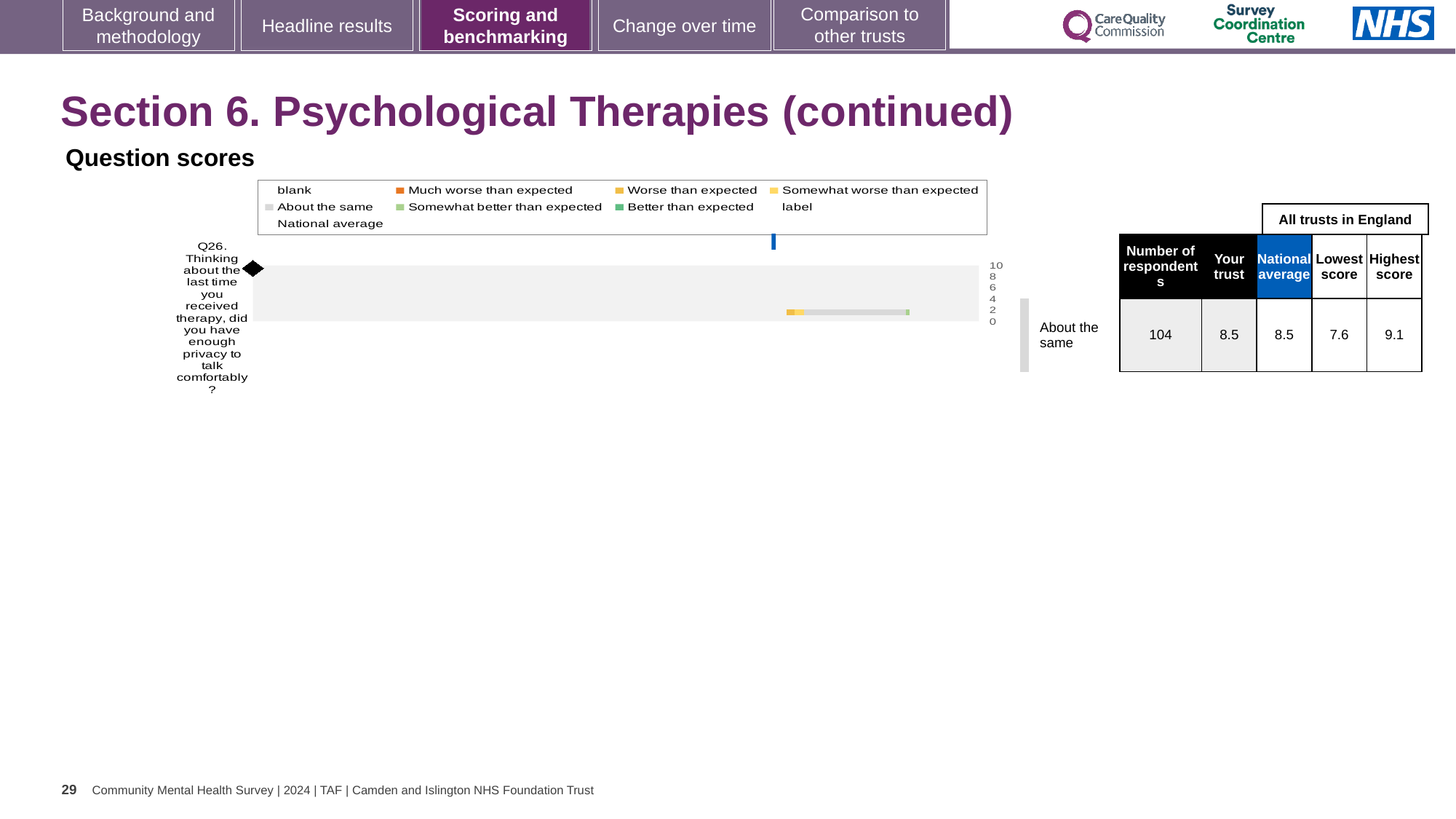
What is the highest score among all trusts in England for Q26? 9.1 What benchmark category is given for Q26 next to the chart? About the same What is the difference between the highest score and the lowest score for Q26? 1.5 How many respondents answered Q26? 104 What is the lowest score among all trusts in England for Q26? 7.6 Is the 'Your trust' score for Q26 larger than, smaller than, or equal to the national average? equal Which question number is plotted in the Question scores chart? Q26 What is the 'Your trust' score for Q26 shown beside the chart? 8.5 What is the national average score for Q26 shown beside the chart? 8.5 What kind of chart is shown under 'Question scores'? bar chart What is the highest tick value shown on the axis of the Question scores chart? 10 How many questions are plotted in the Question scores chart? 1